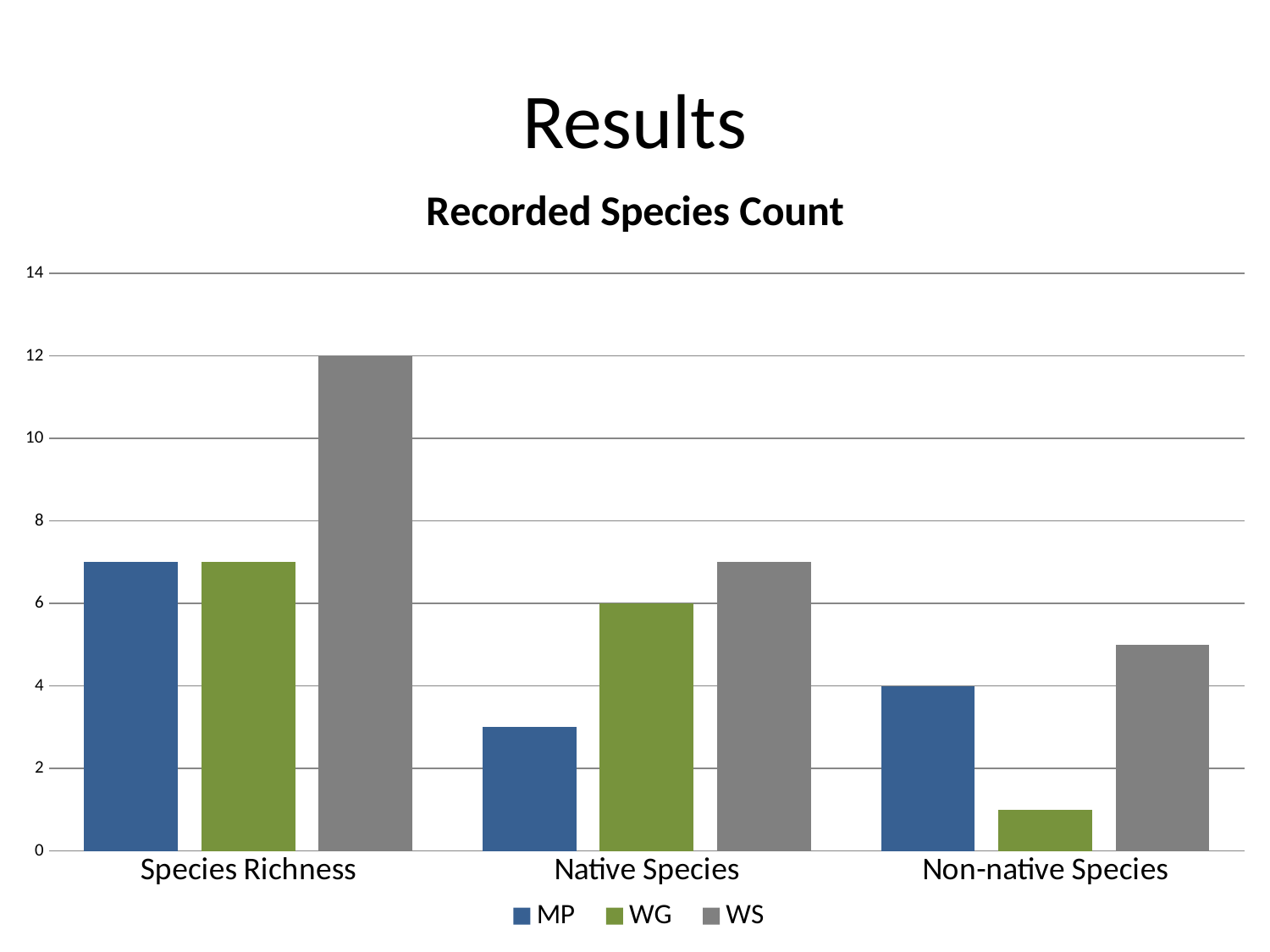
Which is larger in the Native Species category, MP or WS? WS Is the value for WG in the Non-native Species category greater or less than 2? less How many series does the legend list? 3 What is the value for MP in the Non-native Species category? 4 Which series has the lowest value in the Non-native Species category? WG Which series has the highest value in the Species Richness category? WS What type of chart is shown on the slide? Bar chart How many categories are shown on the x axis? 3 What is the value for WG in the Native Species category? 6 What is the difference between the WS value for Species Richness and the WG value for Native Species? 6 What is the value for WS in the Species Richness category? 12 Is the value for MP in the Species Richness category greater or less than 6? greater